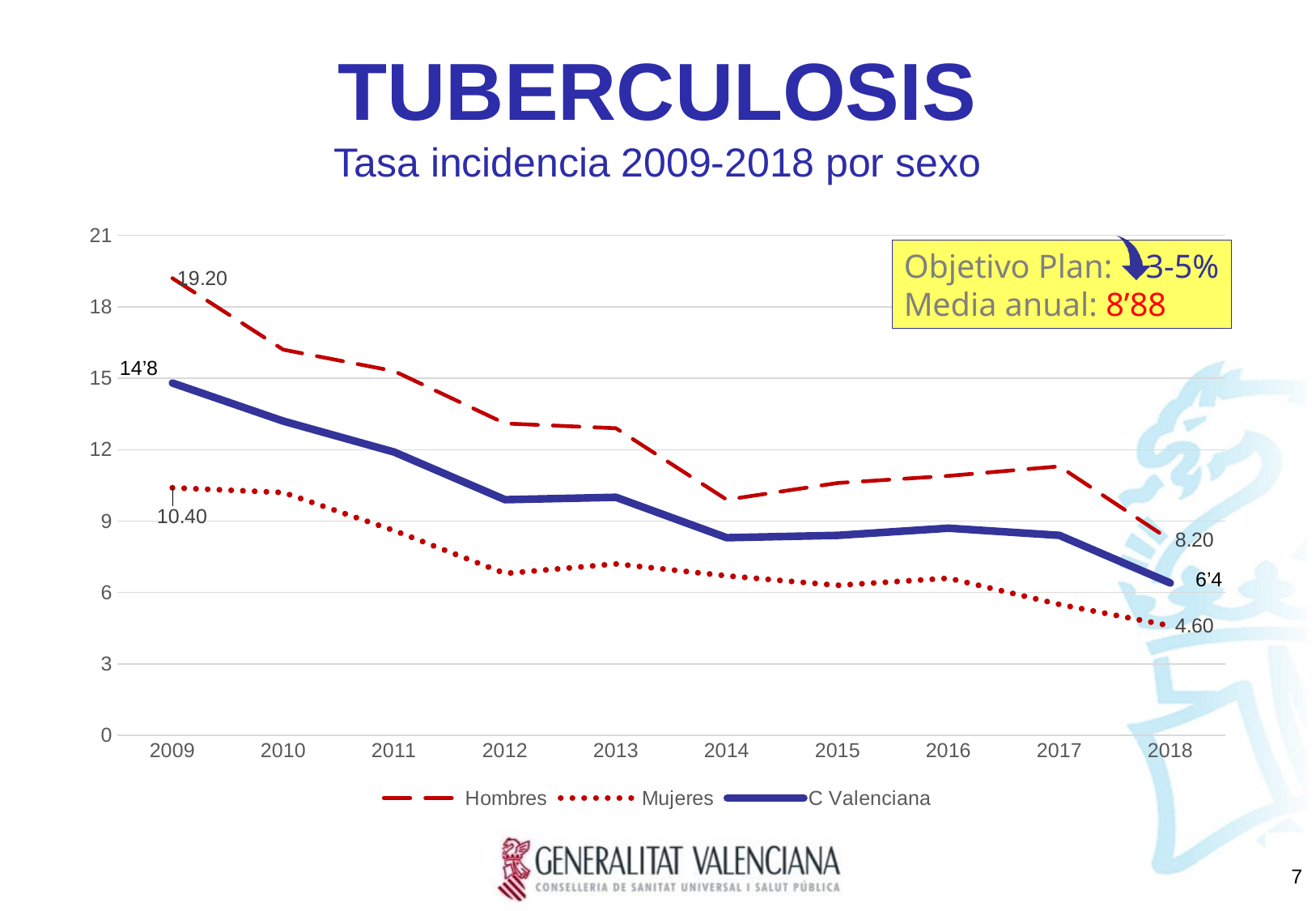
What is the value for Hombres in 2009? 19.20 How many series does the legend list? 3 What is the value for C Valenciana in 2009? 14'8 What is the value for Hombres in 2018? 8.20 Which series has the lowest value in 2018? Mujeres Do the values for C Valenciana generally rise or fall from 2009 to 2018? fall What type of chart is shown on the slide? line chart Is the value for Hombres in 2014 greater or less than 12? less What is the difference between the Hombres values in 2009 and 2018? 11.00 What is the value for Mujeres in 2018? 4.60 How many years are shown on the x axis? 10 Which series has the highest value in 2009? Hombres